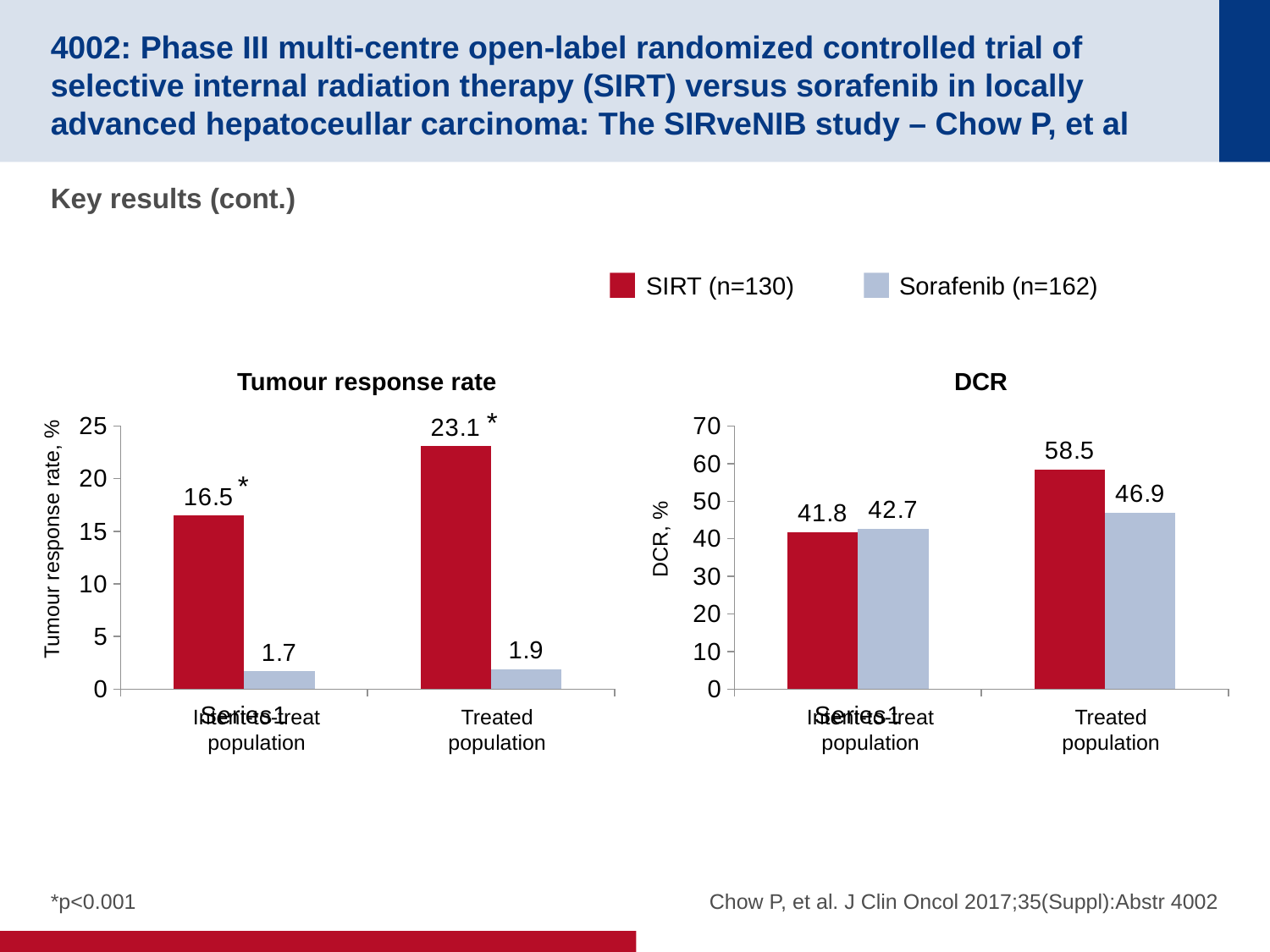
In the Tumour response rate chart, what is the value for SIRT in the Intent-to-treat population? 16.5 What kind of chart is the DCR chart? Bar chart In the Tumour response rate chart, which bar has the highest value? SIRT, Treated population How many series does the legend list? 2 In the DCR chart, what is the value for SIRT in the Treated population? 58.5 In the DCR chart, what is the value for Sorafenib in the Intent-to-treat population? 42.7 In the Tumour response rate chart, what is the value for Sorafenib in the Treated population? 1.9 In the DCR chart, which is larger in the Treated population, SIRT or Sorafenib? SIRT In the Tumour response rate chart, what is the difference between SIRT and Sorafenib in the Intent-to-treat population? 14.8 In the DCR chart, which bar has the lowest value? SIRT, Intent-to-treat population In the DCR chart, what is the difference between SIRT and Sorafenib in the Treated population? 11.6 In the Tumour response rate chart, what colour are the SIRT bars? Red